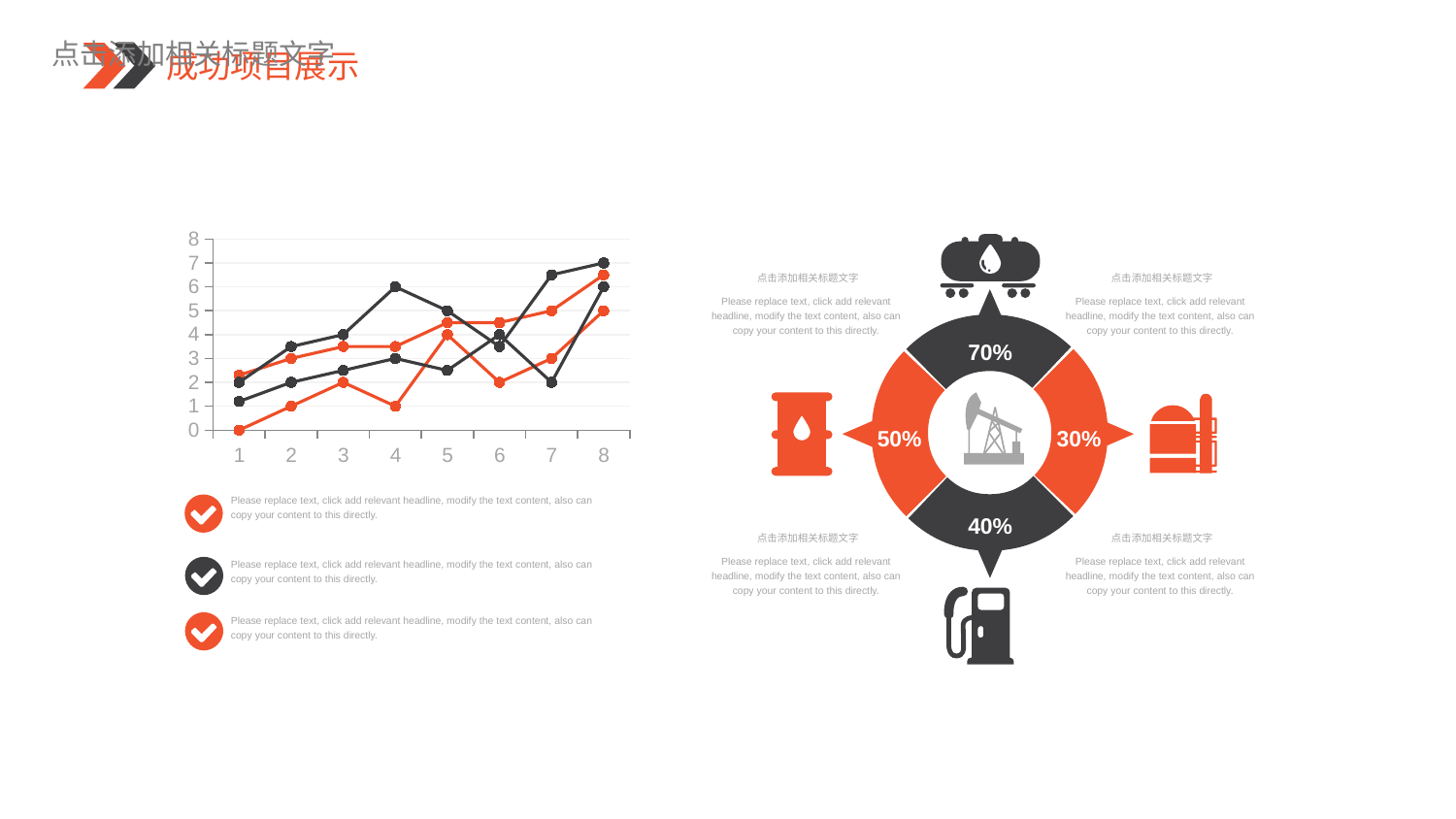
What is the lowest value plotted in the line chart? 0 Is the lowest value at x = 1 in the line chart greater or less than 1? less At which x-axis point does a line reach the highest value in the line chart? 8 How many lines are plotted in the line chart? 4 What is the highest value shown on the y axis of the line chart? 8 What is the highest value reached by any line in the line chart? 7 What type of chart is shown on the left side of the slide? line chart How many points are labelled along the x axis of the line chart? 8 At which x-axis point does a line reach the lowest value in the line chart? 1 Do the lines in the line chart generally rise or fall from x = 1 to x = 8? rise Which two colours are used for the lines in the line chart? dark grey and orange Is the highest value at x = 8 in the line chart greater or less than 6? greater